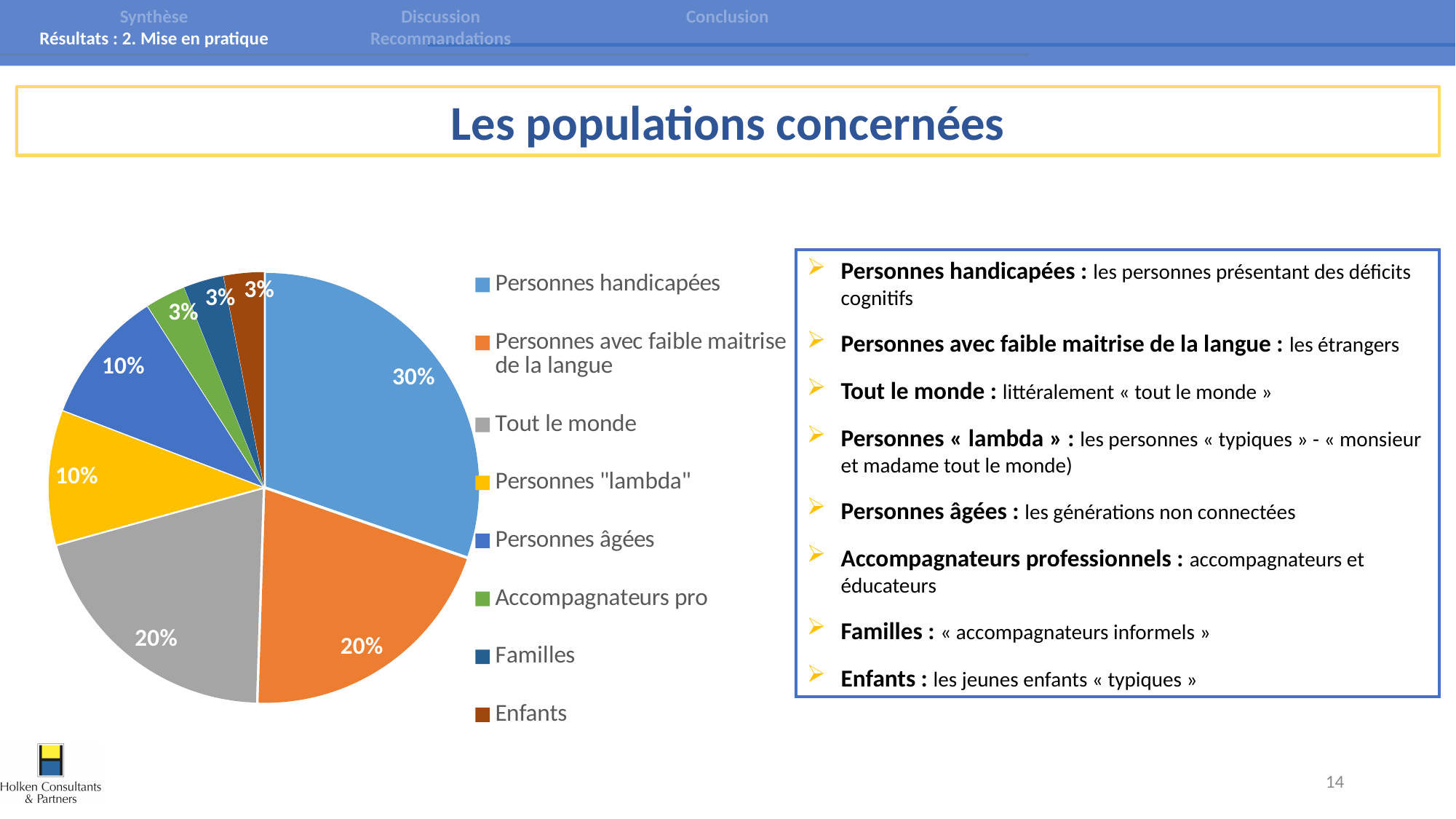
What kind of chart is shown on the slide? pie chart What is the difference between the share for "Personnes handicapées" and the share for "Personnes avec faible maitrise de la langue"? 10% What is the combined share of "Accompagnateurs pro", "Familles" and "Enfants"? 9% Which category has the largest slice of the pie? Personnes handicapées How many entries does the legend list? 8 How many categories does the pie chart contain? 8 Which is larger: the share for "Personnes "lambda"" or the share for "Familles"? Personnes "lambda" What is the value shown for "Enfants"? 3% What is the value shown for "Tout le monde"? 20% What share of the pie does "Personnes handicapées" represent? 30% What colour is the slice for "Personnes avec faible maitrise de la langue"? orange What is the value shown for "Personnes âgées"? 10%